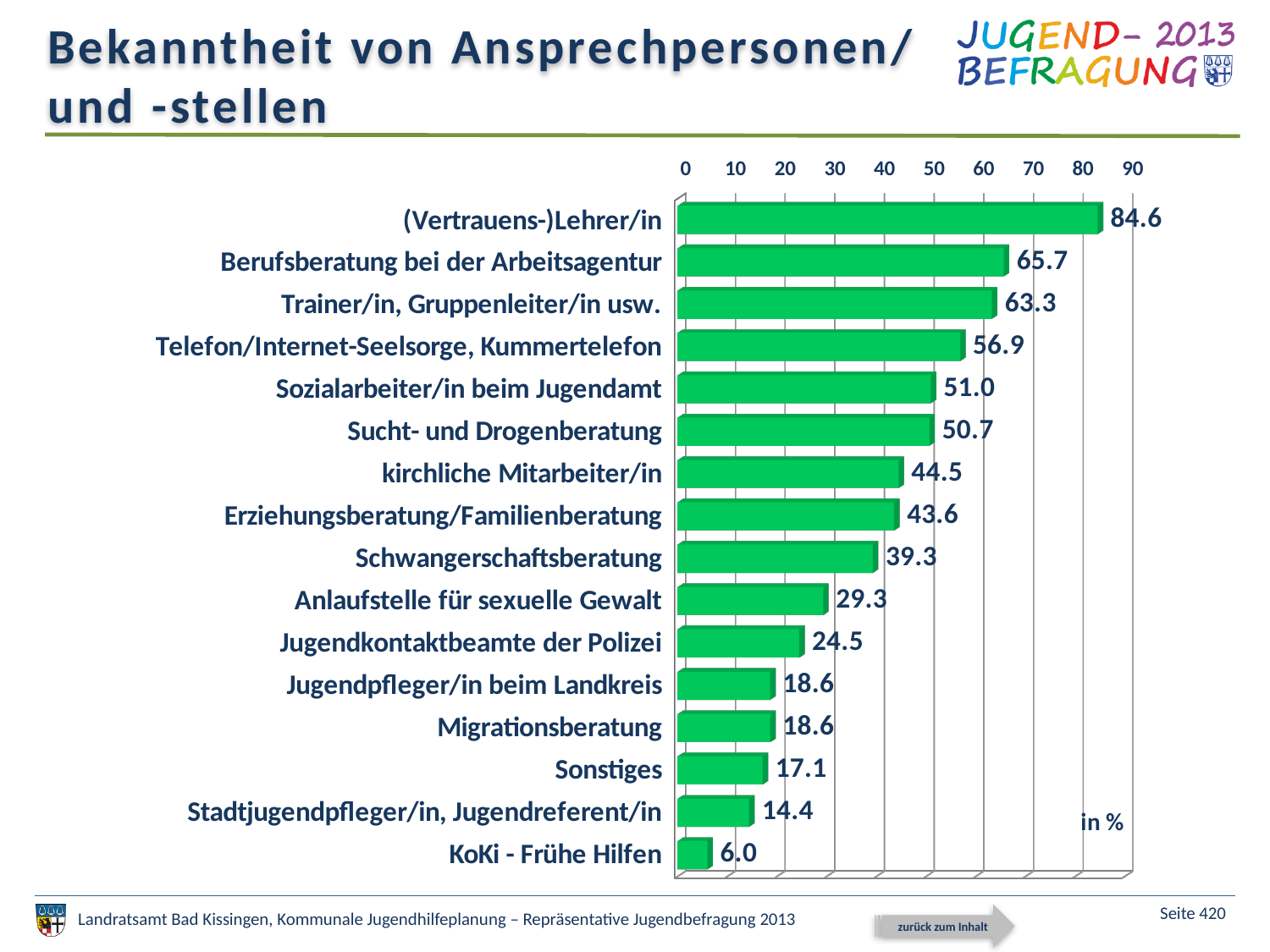
What is the value for Sucht- und Drogenberatung? 50.7 What is the value for KoKi - Frühe Hilfen? 6.0 Which is larger, the value for Schwangerschaftsberatung or the value for Anlaufstelle für sexuelle Gewalt? Schwangerschaftsberatung What kind of chart is shown on the slide? bar chart What is the difference between the values for Berufsberatung bei der Arbeitsagentur and Trainer/in, Gruppenleiter/in usw.? 2.4 What is the value for (Vertrauens-)Lehrer/in? 84.6 Which category has the lowest value? KoKi - Frühe Hilfen What unit is indicated for the values in the chart? in % Is the value for Telefon/Internet-Seelsorge, Kummertelefon greater or less than 50? greater Which category has the highest value? (Vertrauens-)Lehrer/in How many categories are shown in the chart? 16 What is the difference between the values for (Vertrauens-)Lehrer/in and KoKi - Frühe Hilfen? 78.6